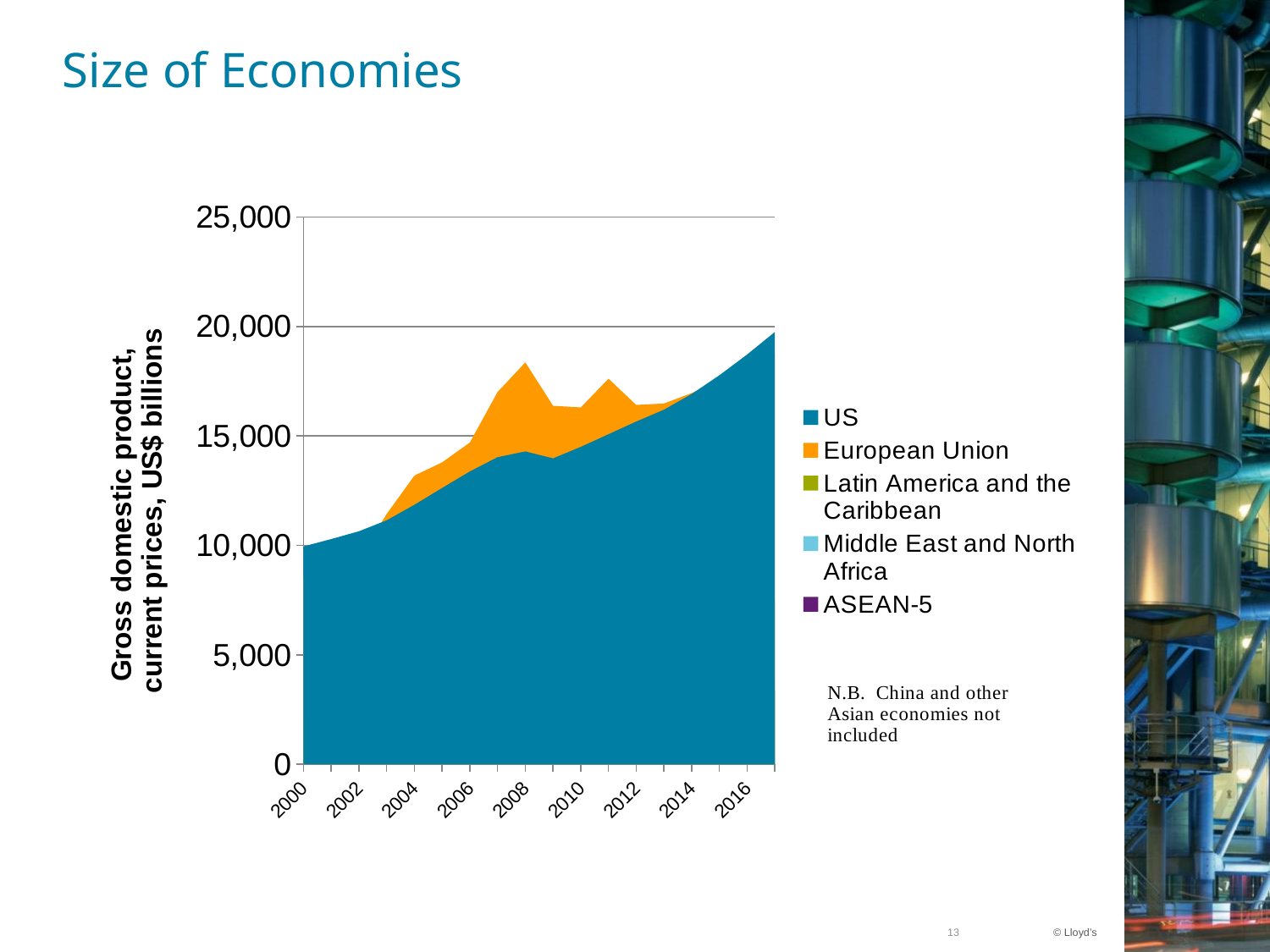
What is the label on the vertical axis? Gross domestic product, current prices, US$ billions What kind of chart is shown on the slide? Area chart In which year shown is the US value highest? 2017 Is the value for the US in 2008 greater or less than 15,000? less In which year shown is the US value lowest? 2000 Is the value for the US in 2004 greater or less than 10,000? greater Does the US series rise or fall from 2000 to 2016? Rise How many series does the legend list? 5 Which colour represents the European Union in the chart? Orange Is the value for the US in 2012 greater or less than 20,000? less How many year labels are shown on the x axis? 9